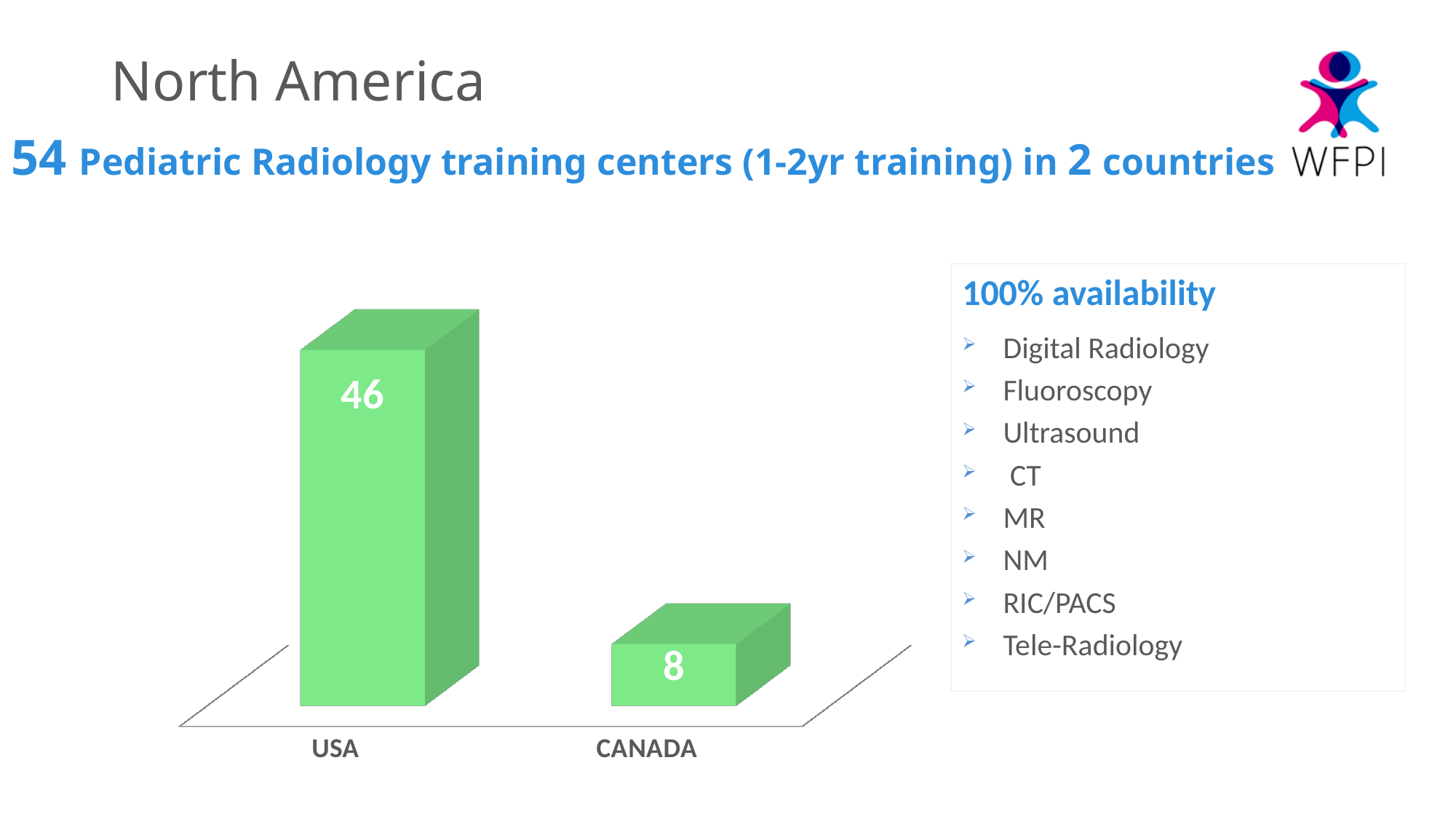
Which category is shown on the left of the chart? USA What is the total of the values for USA and CANADA? 54 Which category has the highest value? USA What is the difference between the values for USA and CANADA? 38 How many categories are shown in the chart? 2 Which category has the lowest value? CANADA Do the values rise or fall from USA to CANADA along the x axis? fall What is the value for USA? 46 What is the value for CANADA? 8 Which is larger, the value for USA or the value for CANADA? USA What colour are the bars in the chart? green What kind of chart is shown on the slide? bar chart